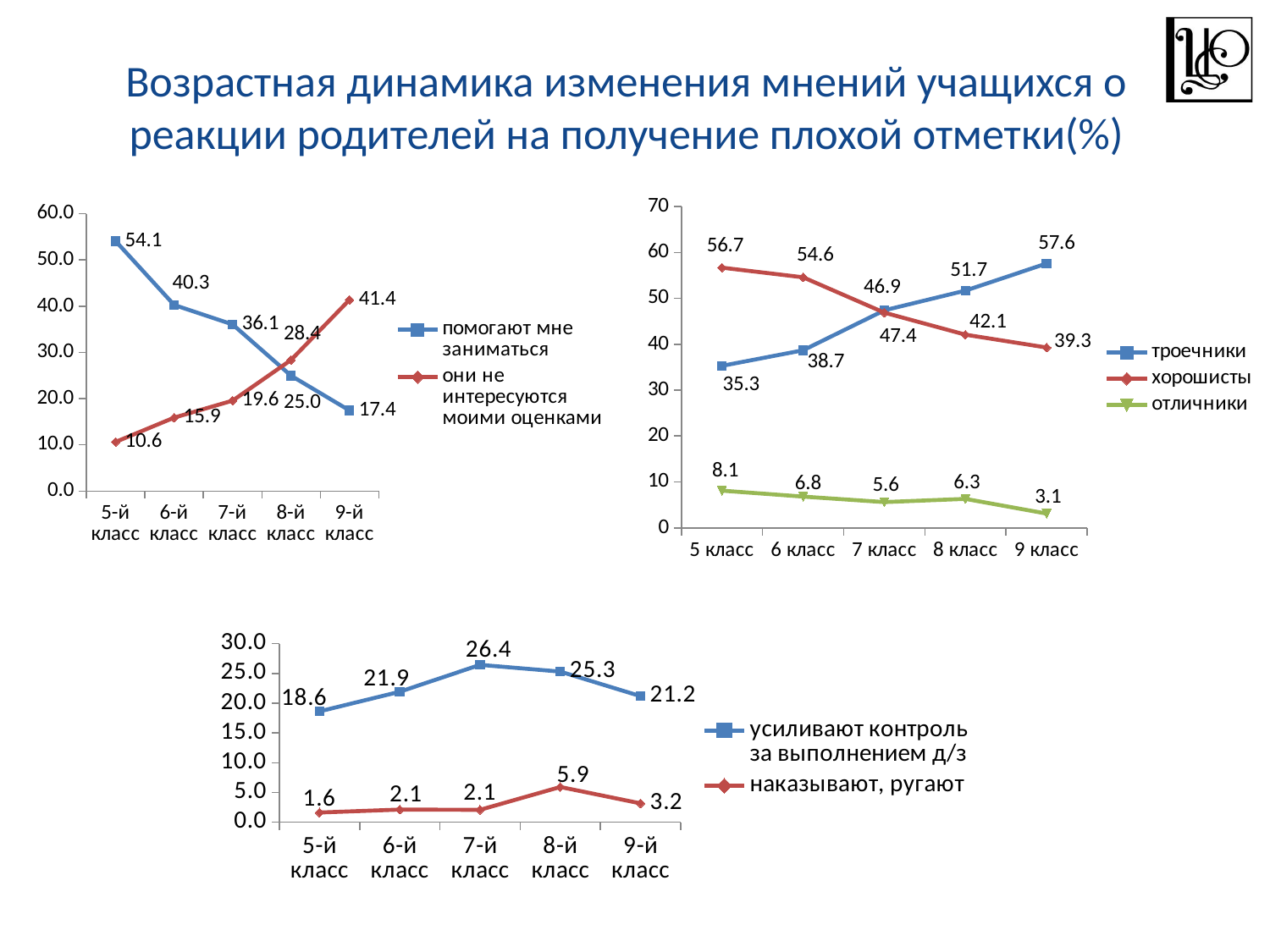
In the top-right chart, in which class is the value for 'хорошисты' lowest? 9 класс What kind of chart is the bottom chart? line chart In the bottom chart, what is the value for 'наказывают, ругают' in 8-й класс? 5.9 In the top-left chart, does the 'помогают мне заниматься' series rise or fall from 5-й класс to 9-й класс? fall In the top-right chart, what is the value for 'троечники' in 9 класс? 57.6 In the top-left chart, what is the difference between 'помогают мне заниматься' and 'они не интересуются моими оценками' in 8-й класс? 3.4 In the bottom chart, in which class is the value for 'усиливают контроль за выполнением д/з' highest? 7-й класс In the top-left chart, what is the value for 'они не интересуются моими оценками' in 9-й класс? 41.4 In the top-left chart, what is the value for 'помогают мне заниматься' in 5-й класс? 54.1 In the top-right chart, what is the value for 'отличники' in 7 класс? 5.6 In the top-right chart, which is larger in 6 класс: 'троечники' or 'хорошисты'? хорошисты In the top-right chart, how many series does the legend list? 3